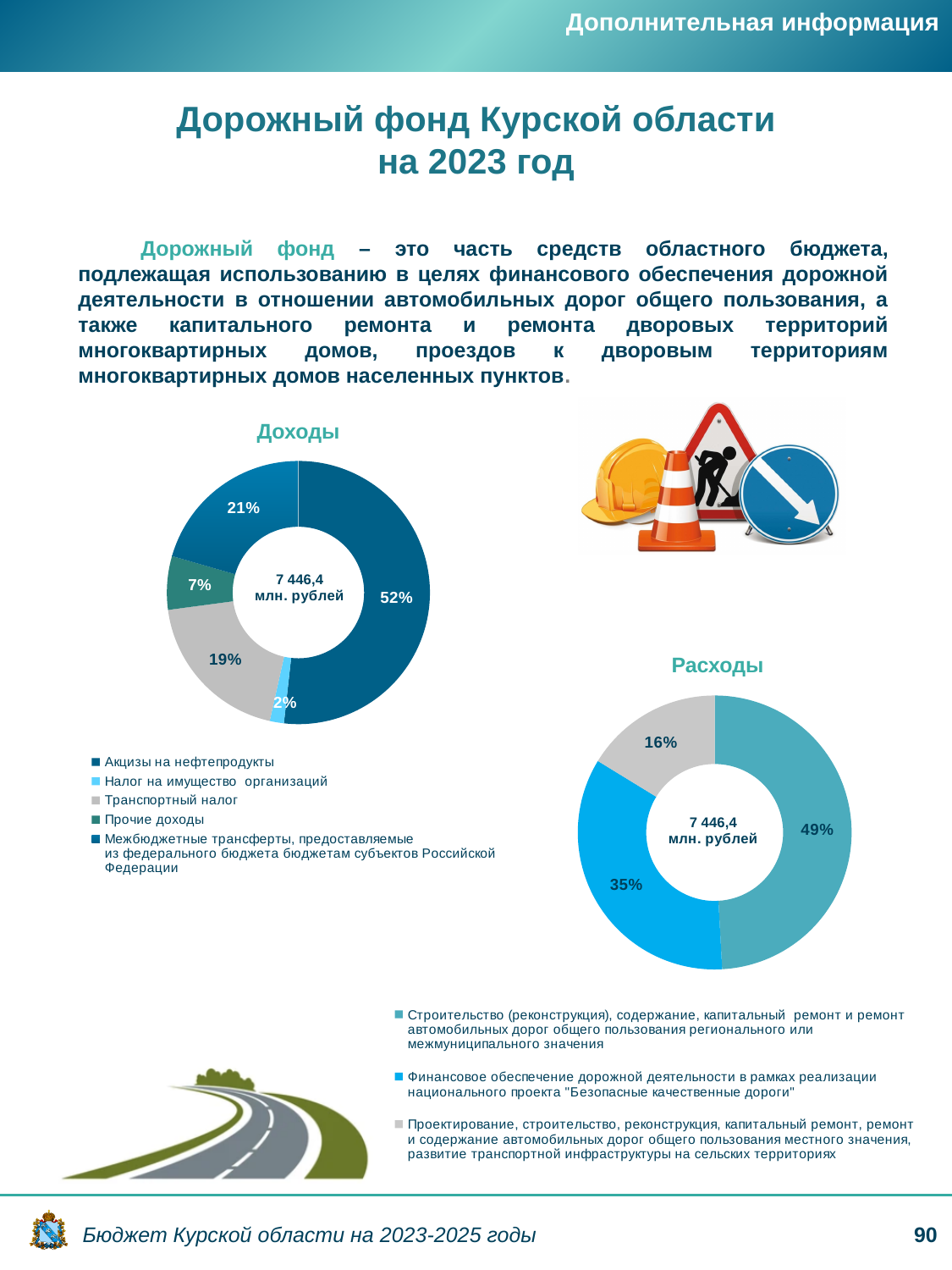
On the "Расходы" chart, which category has the largest share? Строительство (реконструкция), содержание, капитальный ремонт и ремонт автомобильных дорог общего пользования регионального или межмуниципального значения On the "Доходы" chart, what share is shown for Транспортный налог? 19% On the "Доходы" chart, what share is shown for Налог на имущество организаций? 2% On the "Доходы" chart, what is the difference in percentage points between Межбюджетные трансферты and Прочие доходы? 14 On the "Доходы" chart, which category has the smallest share? Налог на имущество организаций On the "Доходы" chart, which category has the largest share? Акцизы на нефтепродукты On the "Доходы" chart, what share is shown for Акцизы на нефтепродукты? 52% On the "Расходы" chart, what share is shown for Финансовое обеспечение дорожной деятельности в рамках реализации национального проекта "Безопасные качественные дороги"? 35% What kind of chart is the "Расходы" chart? Pie (donut) chart How many categories does the "Доходы" chart show? 5 How many categories does the "Расходы" chart show? 3 What total value is printed in the centre of the "Доходы" chart? 7 446,4 млн. рублей